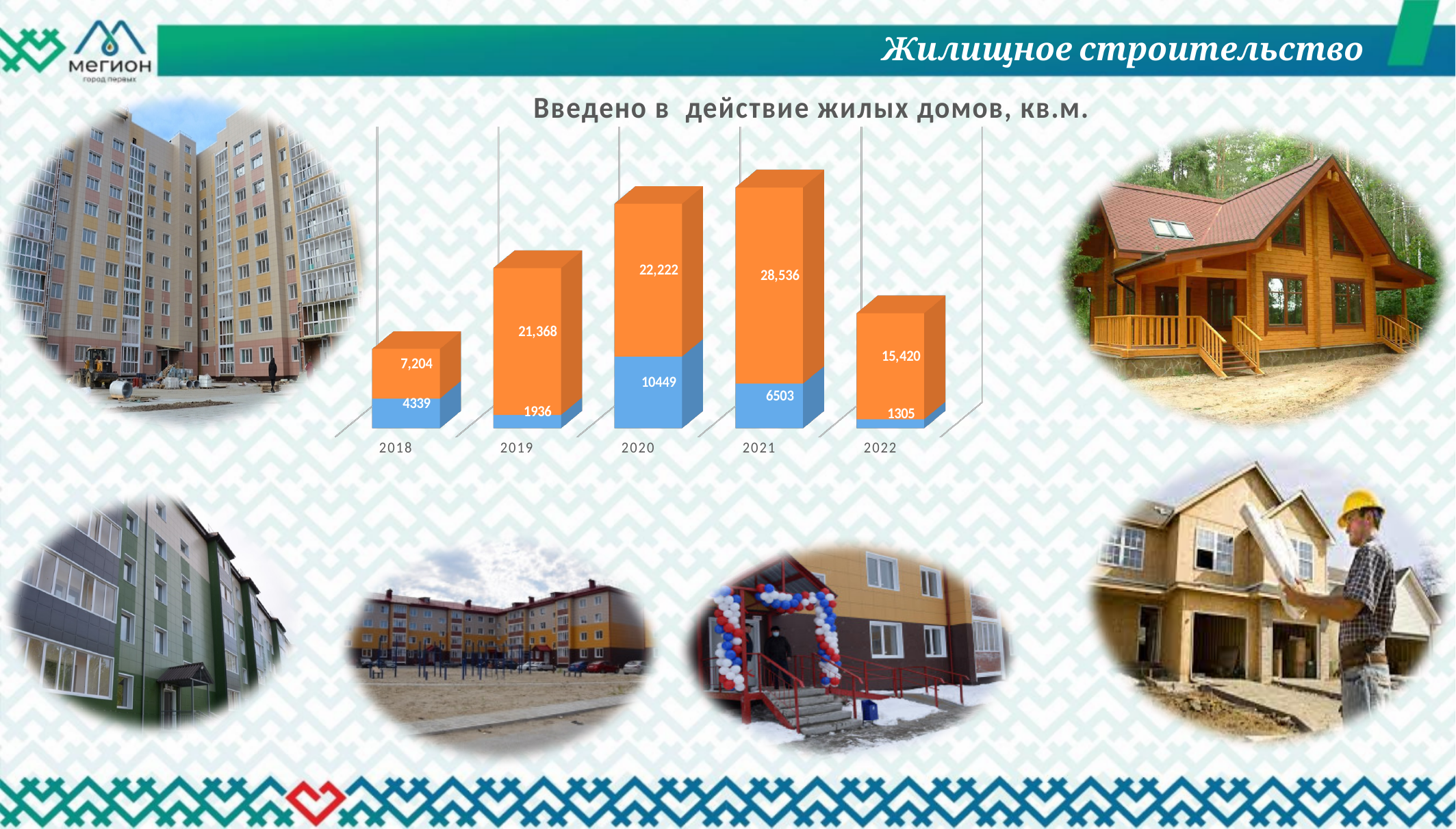
Does the orange segment value rise or fall from 2018 to 2021? Rises What is the title of the chart? Введено в действие жилых домов, кв.м. What kind of chart is shown on the slide? Stacked bar chart Which year has the larger blue segment value, 2018 or 2021? 2021 Which year has the highest orange segment value? 2021 Which year has the lowest blue segment value? 2022 What is the difference between the orange segment values for 2020 and 2019? 854 What is the value of the orange segment for 2021? 28,536 What is the total of the stacked bar for 2021? 35039 How many years are shown on the x axis of the chart? 5 What is the value of the orange segment for 2022? 15,420 What is the value of the blue segment for 2020? 10449